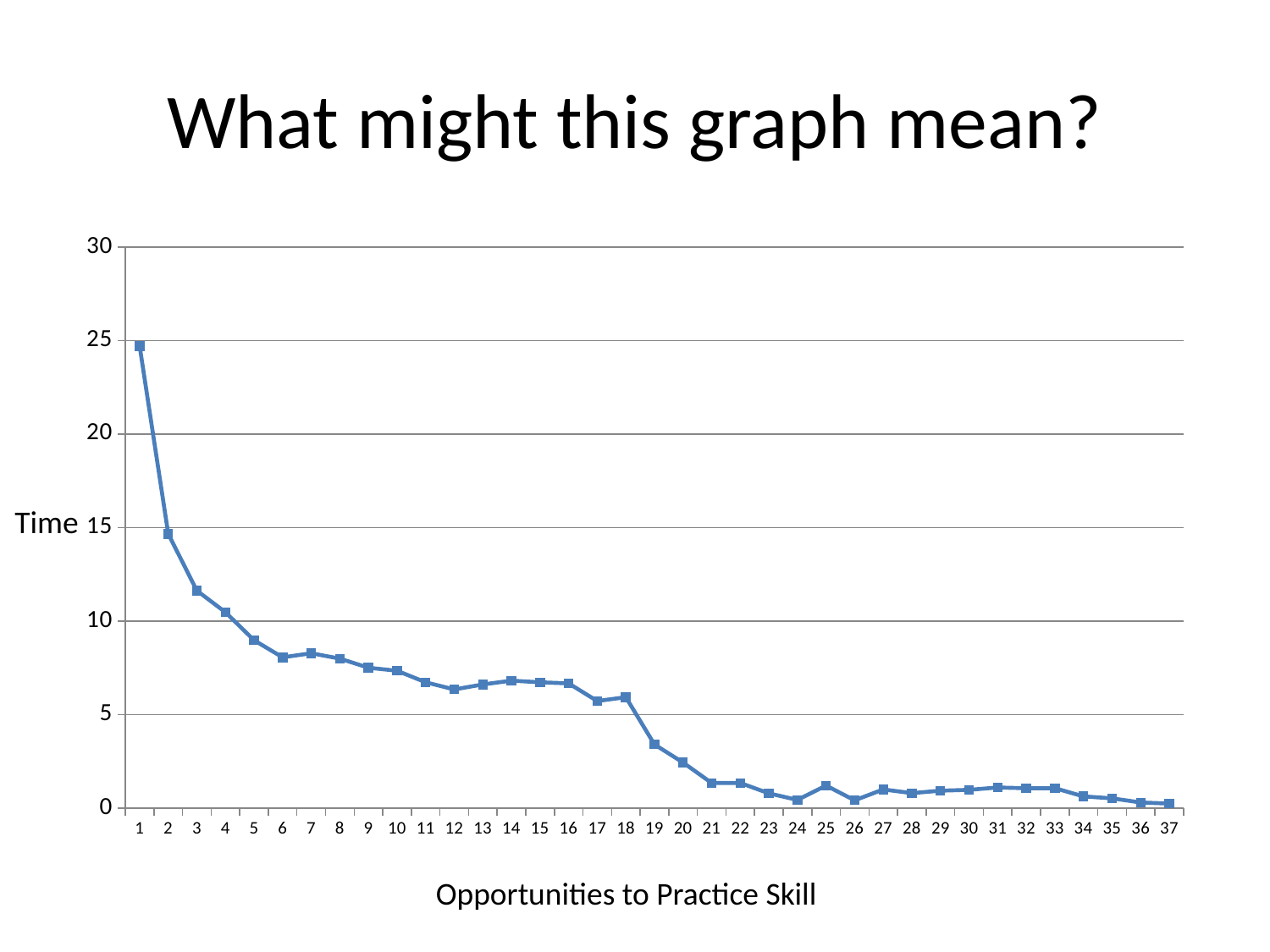
Is the value at opportunity 6 greater or less than 10? less At which opportunity number is the time value highest? 1 What kind of chart is shown on the slide? line chart Do the values generally rise or fall as the number of opportunities to practice the skill increases? fall Is the value at opportunity 24 greater or less than 5? less How many data points are plotted along the x axis? 37 Which has the larger value, opportunity 18 or opportunity 19? opportunity 18 What is the label on the x axis of the chart? Opportunities to Practice Skill Is the value at opportunity 19 greater or less than 5? less What is the label on the y axis of the chart? Time